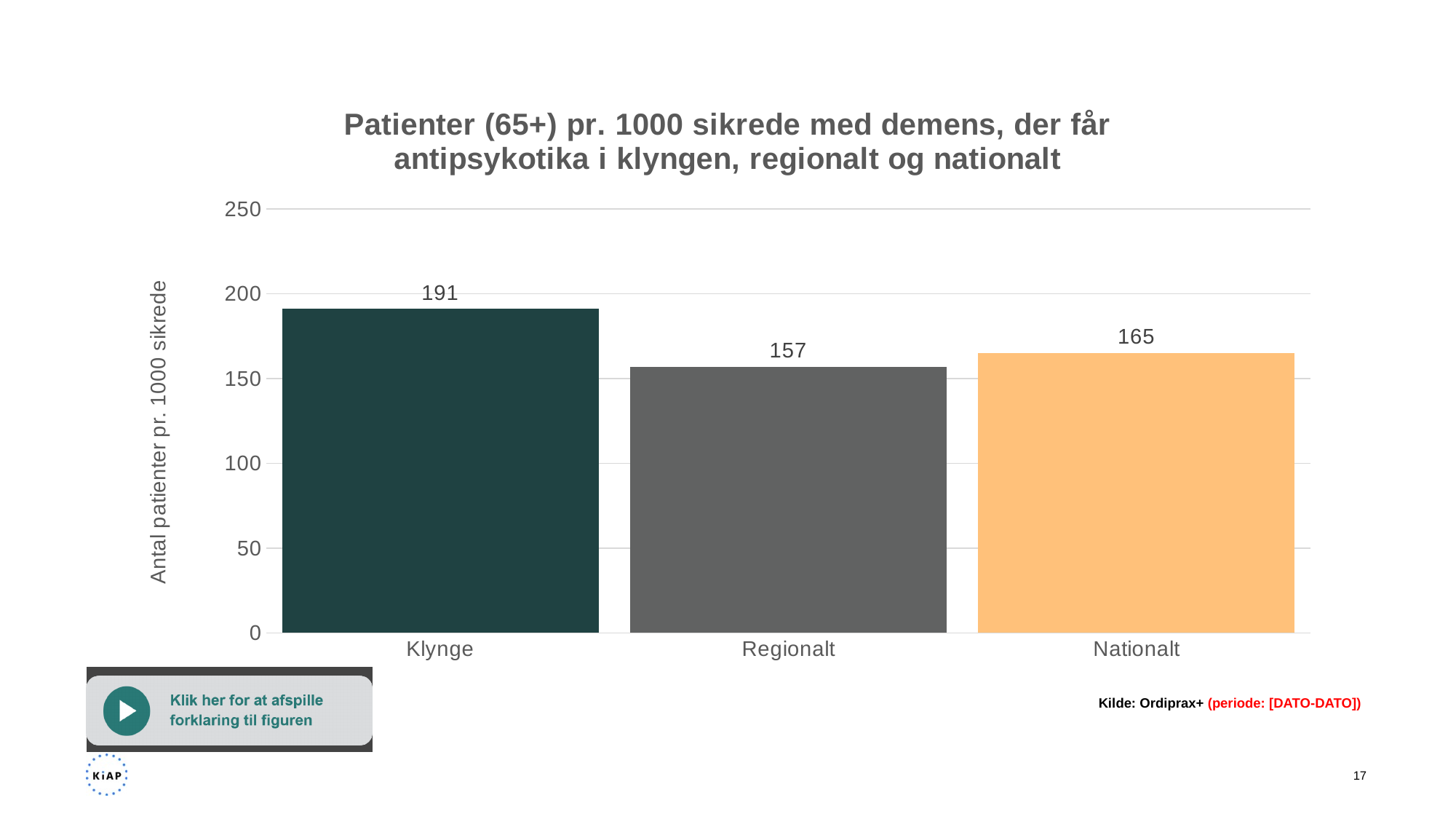
What is the difference between the values for Klynge and Regionalt? 34 What is the label of the y axis? Antal patienter pr. 1000 sikrede Which is larger, the value for Nationalt or the value for Regionalt? Nationalt What is the value for Regionalt? 157 What is the difference between the values for Nationalt and Regionalt? 8 How many categories are shown on the x axis? 3 Is the value for Klynge greater or less than 200? less What is the value for Nationalt? 165 What is the value for Klynge? 191 Which category has the lowest value? Regionalt Which category has the highest value? Klynge What kind of chart is shown on the slide? bar chart